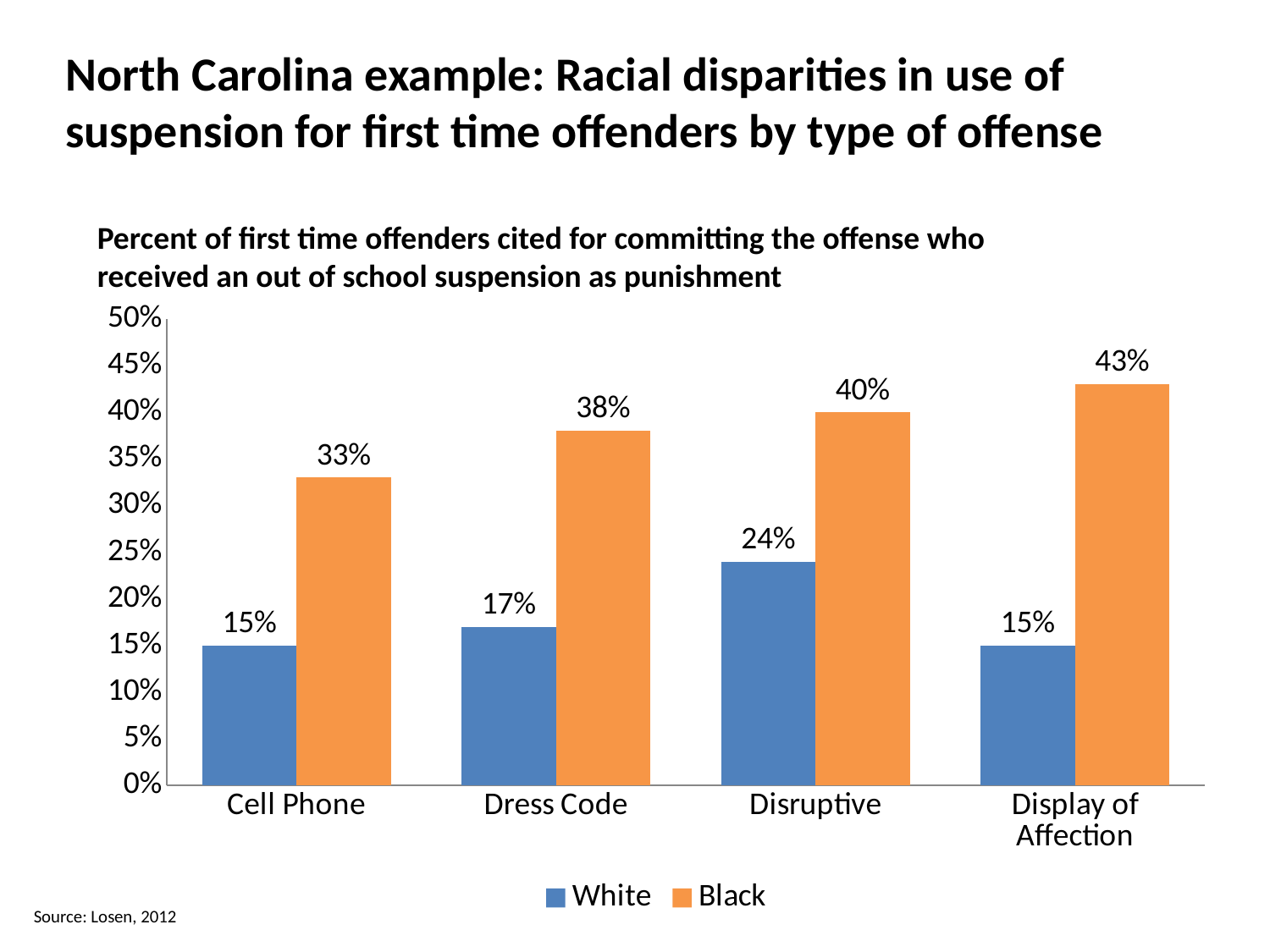
Which offense category has the lowest value for Black students? Cell Phone How many offense categories are shown on the x axis? 4 What is the value for White students in the Disruptive category? 24% Which is larger: the White value for Dress Code or the White value for Cell Phone? Dress Code What kind of chart is shown on the slide? Bar chart Which offense category has the highest value for White students? Disruptive What is the difference between the Black and White values for Disruptive? 16% How many series does the legend list? 2 Which offense category has the highest value for Black students? Display of Affection What is the value for Black students in the Dress Code category? 38% What percent of White first time offenders cited for a Cell Phone offense received an out of school suspension? 15% What is the difference between the Black and White values for Display of Affection? 28%